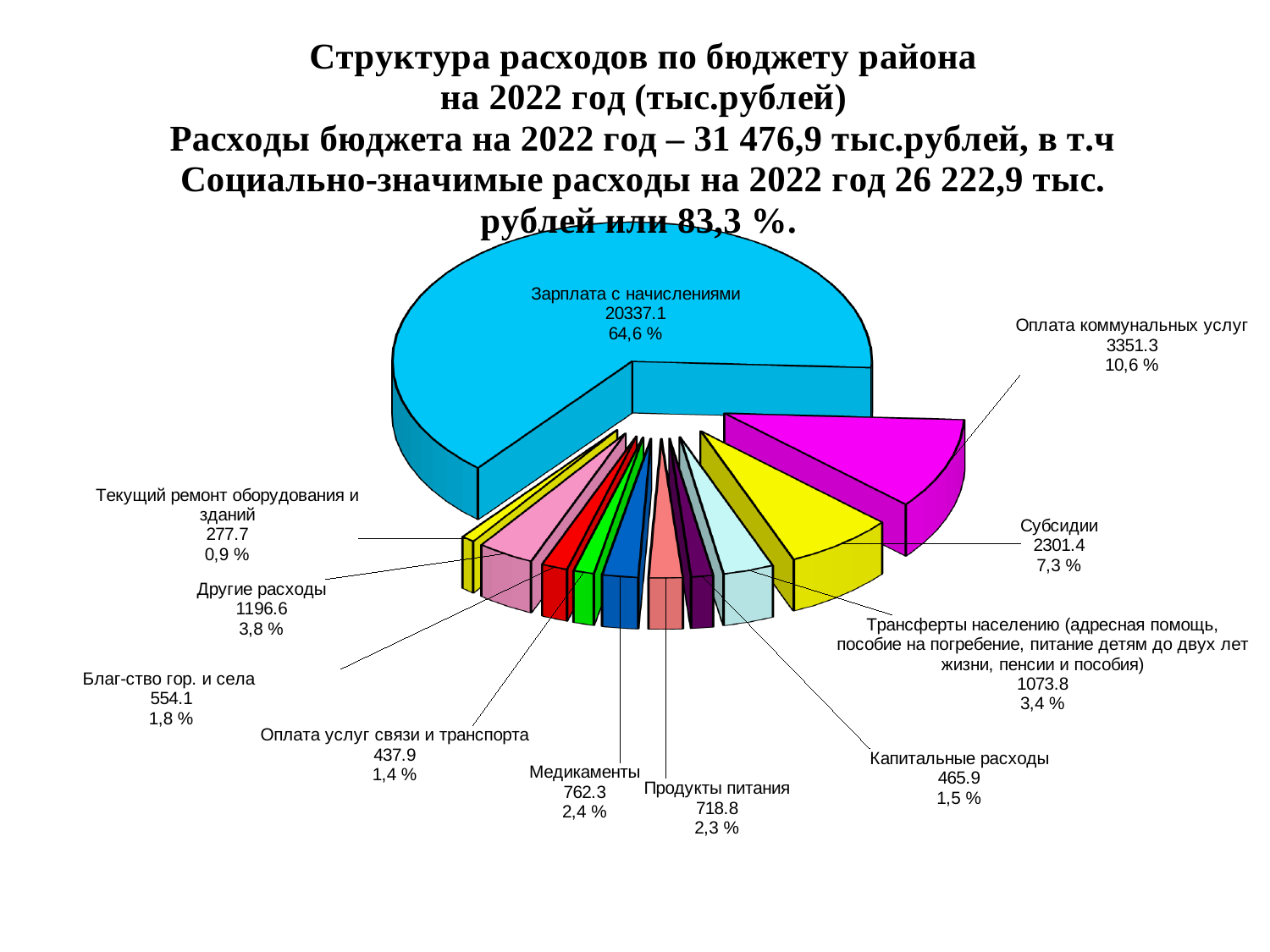
What kind of chart is shown on the slide? Pie chart What share of the pie does Другие расходы represent? 3,8 % What is the difference between the values for Оплата коммунальных услуг and Субсидии? 1049.9 Which is larger, the value for Продукты питания or the value for Медикаменты? Медикаменты What share of the pie does Субсидии represent? 7,3 % How many categories (slices) does the pie chart have? 11 What is the value for Зарплата с начислениями? 20337.1 Which category has the largest slice of the pie? Зарплата с начислениями What is the value for Оплата коммунальных услуг? 3351.3 What is the value for Капитальные расходы? 465.9 What is the value for Медикаменты? 762.3 Which category has the smallest slice of the pie? Текущий ремонт оборудования и зданий